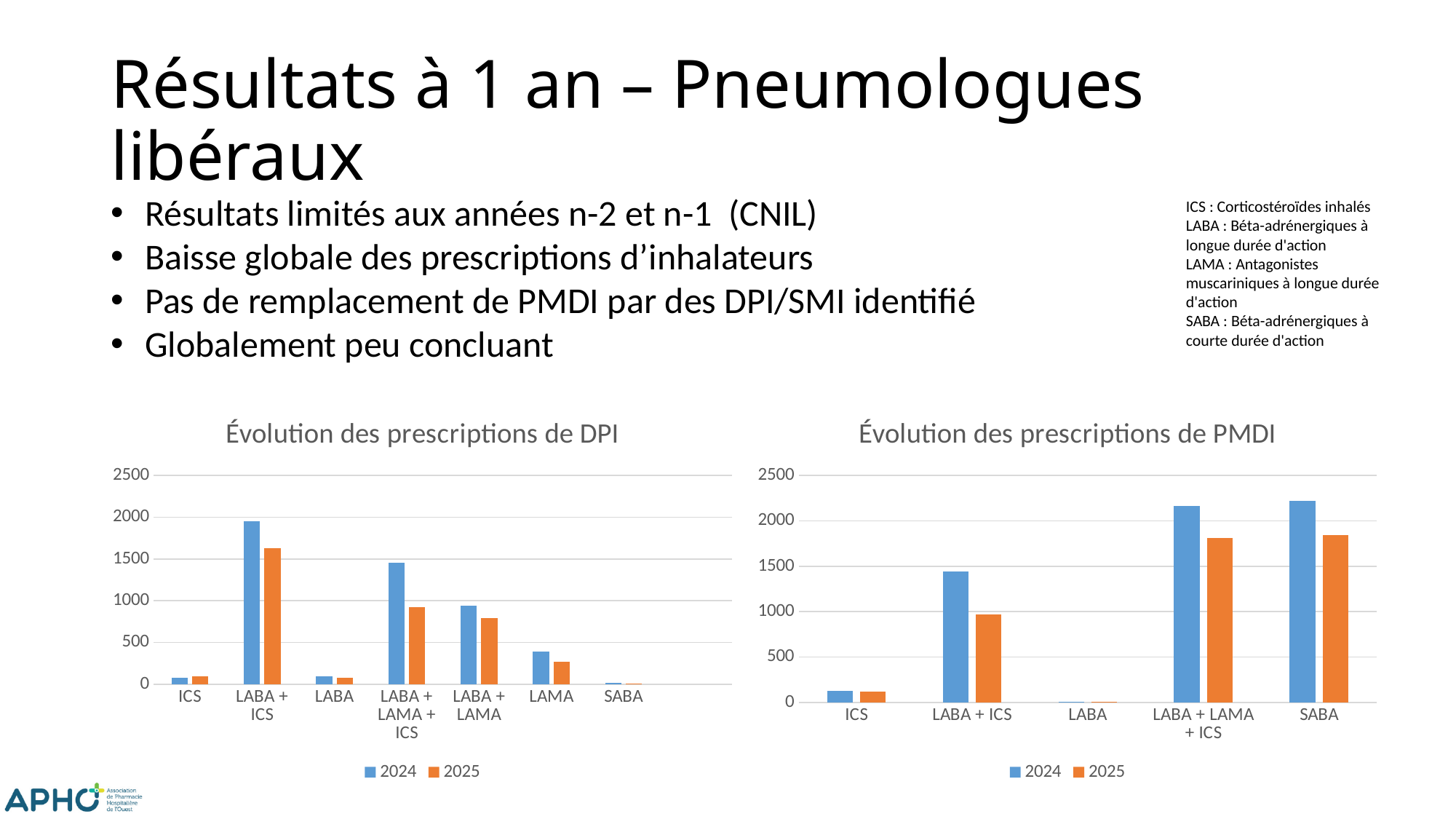
How many categories are shown on the x axis of the "Évolution des prescriptions de PMDI" chart? 5 What are the two series listed in the legend of the "Évolution des prescriptions de DPI" chart? 2024 and 2025 How many series does the legend of the "Évolution des prescriptions de PMDI" chart list? 2 In the "Évolution des prescriptions de DPI" chart, which category has the lowest 2024 value? SABA In the "Évolution des prescriptions de PMDI" chart, which category has the lowest 2025 value? LABA In the "Évolution des prescriptions de DPI" chart, is the 2024 value for LABA + ICS greater or less than 1500? greater In the "Évolution des prescriptions de PMDI" chart, is the 2024 value for SABA greater or less than 2000? greater In the "Évolution des prescriptions de PMDI" chart, which is larger for LABA + LAMA + ICS, the 2024 value or the 2025 value? 2024 How many categories are shown on the x axis of the "Évolution des prescriptions de DPI" chart? 7 In the "Évolution des prescriptions de DPI" chart, which category has the highest 2024 value? LABA + ICS What kind of chart is "Évolution des prescriptions de DPI"? bar chart In the "Évolution des prescriptions de DPI" chart, is the 2025 value for LABA + LAMA + ICS greater or less than 1000? less